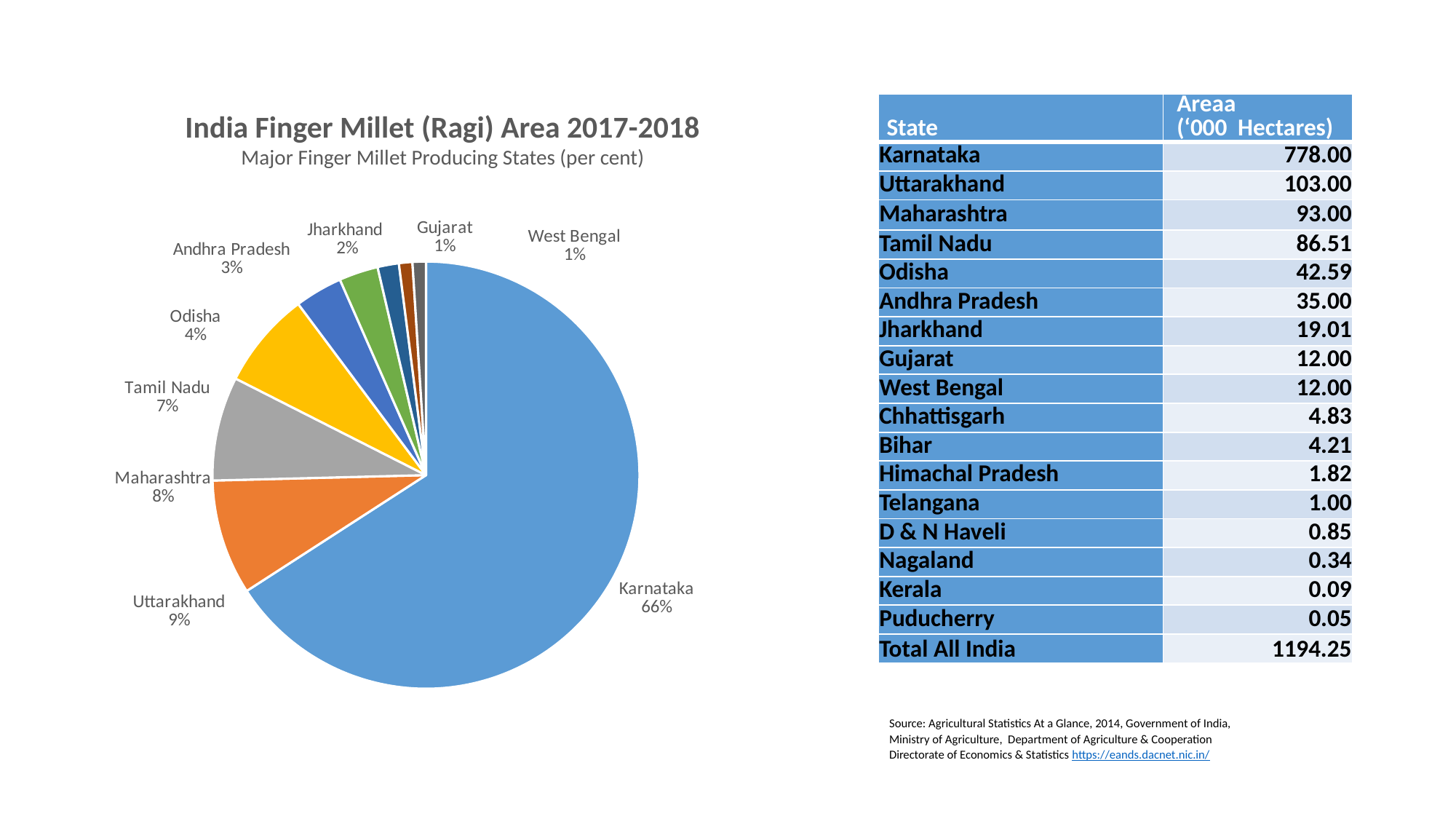
What is the title of the chart? India Finger Millet (Ragi) Area 2017-2018 What percentage is shown for Odisha in the pie chart? 4% What percentage is shown for Jharkhand in the pie chart? 2% How many slices does the pie chart have? 9 What kind of chart is shown on the slide? pie chart What share of the pie does Karnataka hold? 66% What is the subtitle shown below the chart title? Major Finger Millet Producing States (per cent) What percentage is shown for Uttarakhand in the pie chart? 9% What is the difference in percentage points between Karnataka's share and Uttarakhand's share in the pie chart? 57 Which has the larger share in the pie chart, Maharashtra or Tamil Nadu? Maharashtra Which state has the largest slice of the pie chart? Karnataka What percentage is shown for Tamil Nadu in the pie chart? 7%